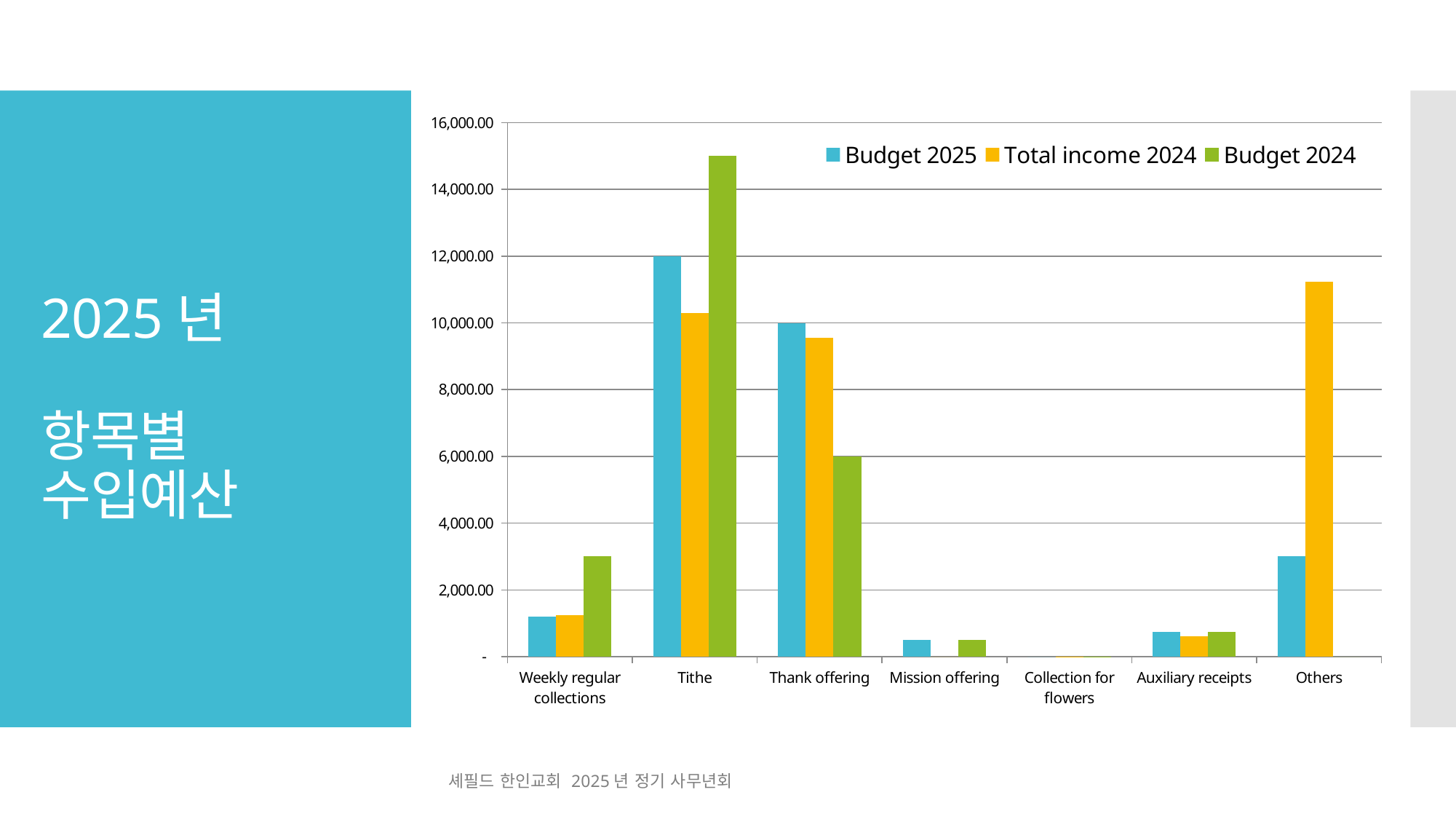
What is the Budget 2025 value for Tithe? 12,000.00 Is the Budget 2024 value for Tithe greater or less than 14,000.00? greater What is the Budget 2024 value for Thank offering? 6,000.00 Is the Total income 2024 value for Others greater or less than 10,000.00? greater Which category has the highest Budget 2024 value? Tithe What is the difference between Budget 2025 and Budget 2024 for Thank offering? 4,000.00 How many categories are shown on the x axis? 7 Which category has the highest Total income 2024 value? Others What is the Budget 2025 value for Thank offering? 10,000.00 What type of chart is shown on the slide? bar chart How many series does the legend list? 3 For Tithe, which is larger: Budget 2025 or Budget 2024? Budget 2024